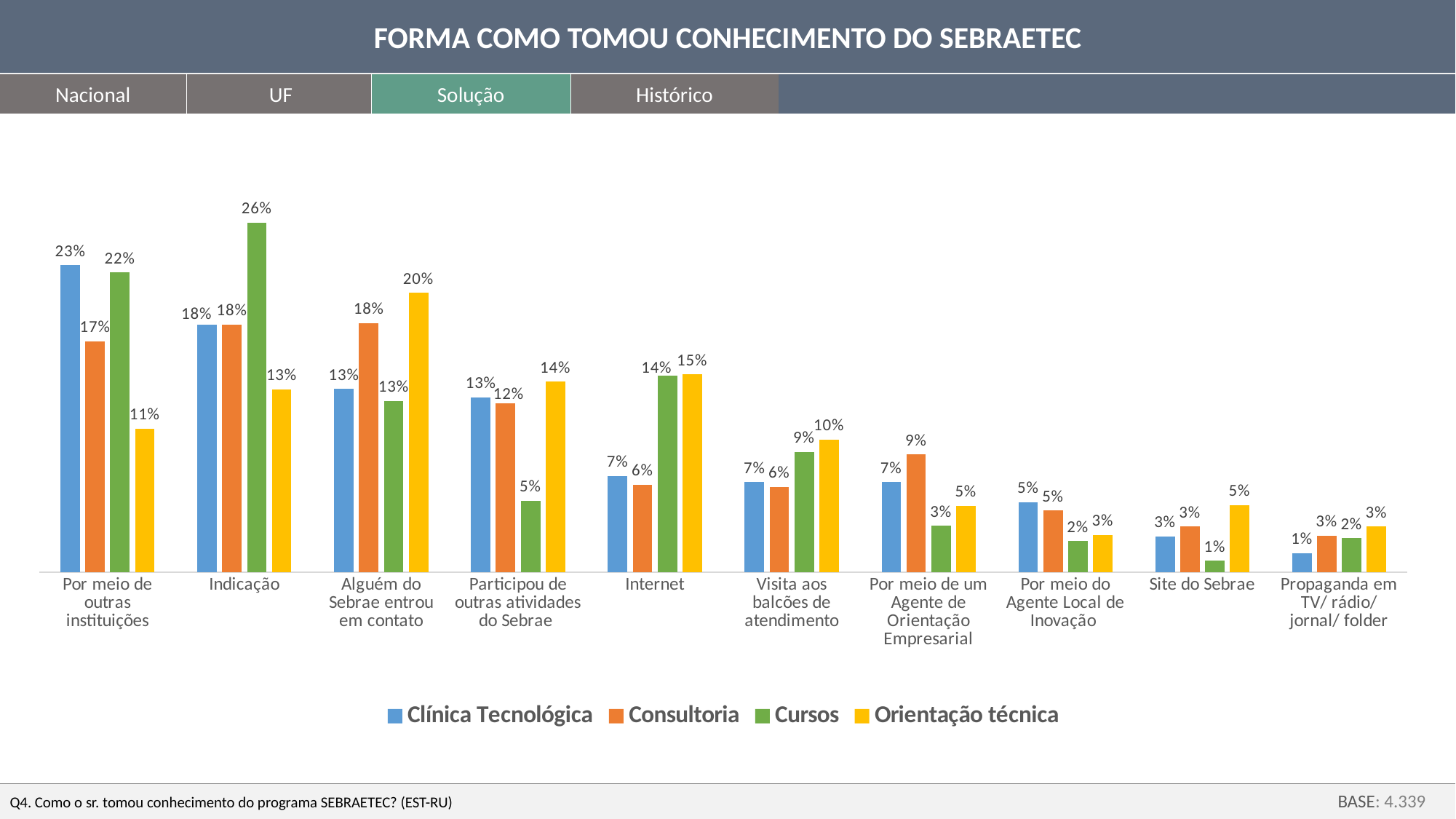
What is the value for Cursos in the Indicação category? 26% Which is larger in the Internet category: Clínica Tecnológica or Cursos? Cursos What is the difference between Orientação técnica and Cursos in the 'Alguém do Sebrae entrou em contato' category? 7% Which series has the highest value in the 'Por meio de outras instituições' category? Clínica Tecnológica What type of chart is shown on the slide? bar chart How many series does the legend list? 4 What is the value for Consultoria in the 'Alguém do Sebrae entrou em contato' category? 18% How many categories are shown on the x axis? 10 Which series has the lowest value in the 'Site do Sebrae' category? Cursos What is the value for Clínica Tecnológica in the 'Propaganda em TV/ rádio/ jornal/ folder' category? 1% What is the value for Orientação técnica in the Internet category? 15% Which colour represents the Consultoria series in the legend? orange